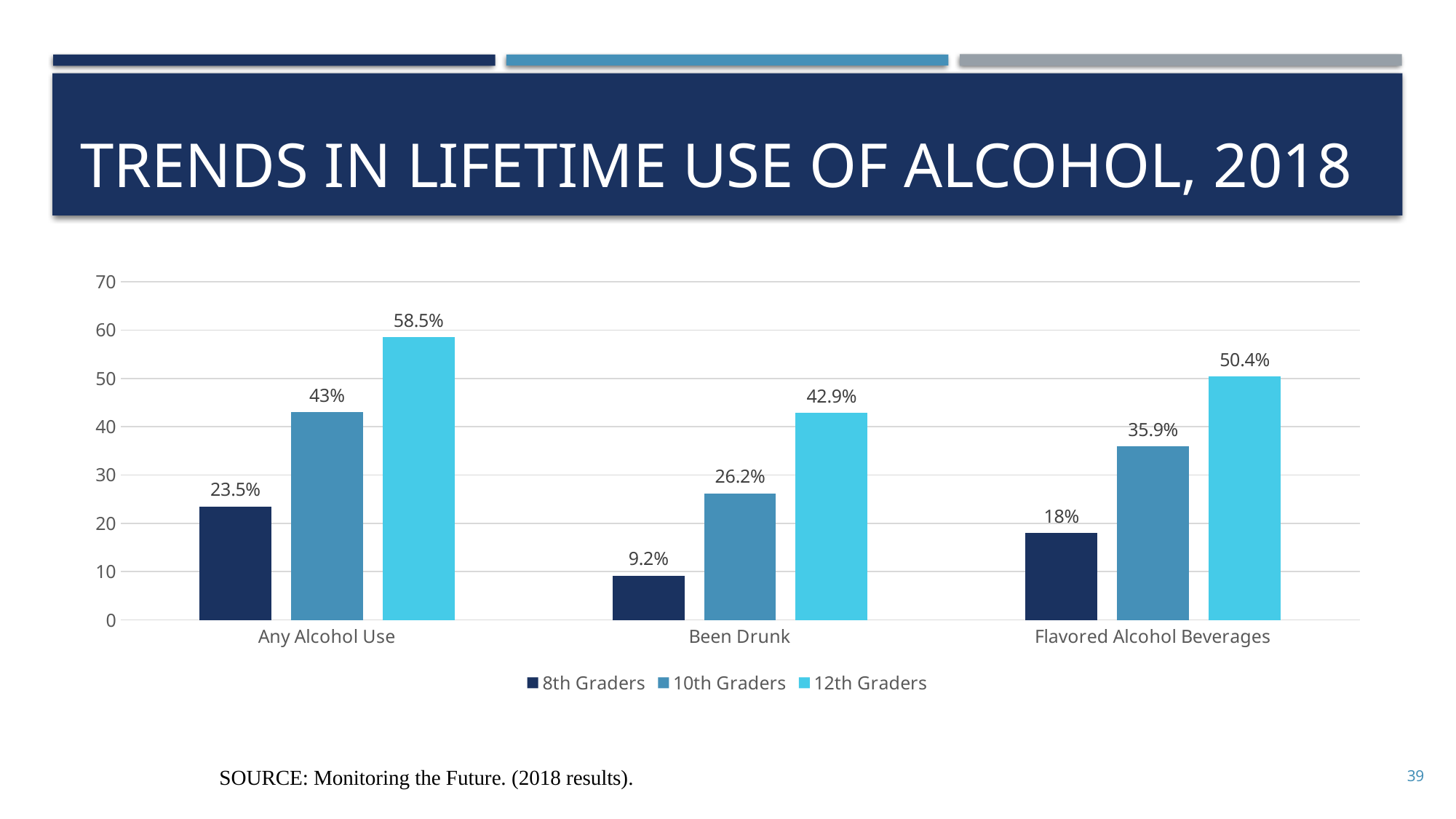
Which category has the highest value for 8th Graders? Any Alcohol Use Which is larger: the 10th Graders value for Any Alcohol Use or the 12th Graders value for Been Drunk? 10th Graders value for Any Alcohol Use How many series does the legend list? 3 What is the difference between the 12th Graders and 8th Graders values for Been Drunk? 33.7% What is the value for 12th Graders in the Any Alcohol Use category? 58.5% Which category has the lowest value for 12th Graders? Been Drunk Is the value for 12th Graders in Flavored Alcohol Beverages greater or less than 50? greater What is the value for 10th Graders in the Flavored Alcohol Beverages category? 35.9% What kind of chart is shown on the slide? Bar chart What is the value for 8th Graders in the Been Drunk category? 9.2% What is the title of the chart on the slide? TRENDS IN LIFETIME USE OF ALCOHOL, 2018 How many categories are shown on the x axis? 3